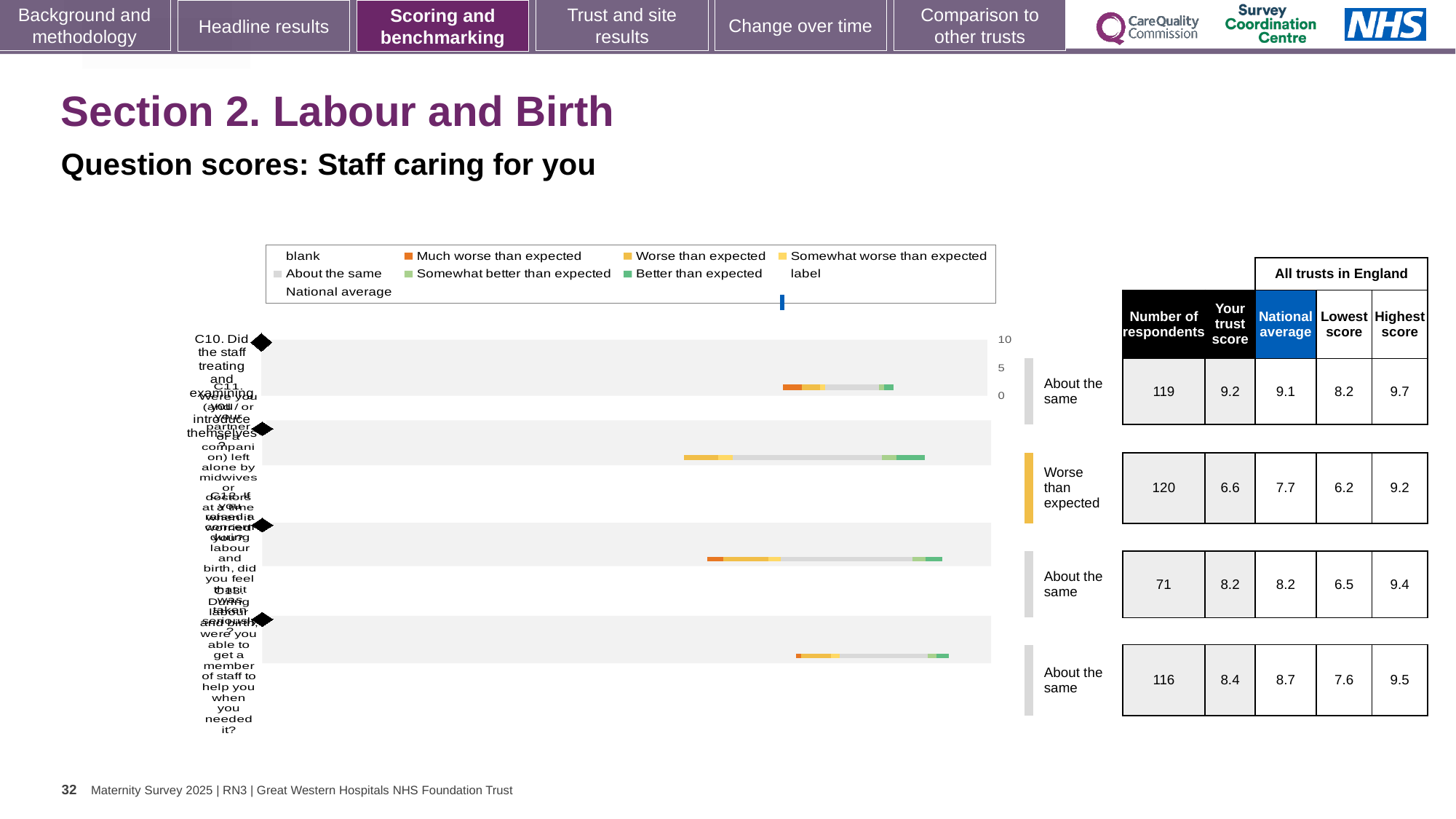
In the table, what is the number of respondents for the second row (the one rated 'Worse than expected')? 120 What is the lowest score among all trusts in England for the first row? 8.2 How many question rows are plotted in the chart? 4 How many of the four rows are rated 'About the same'? 3 What kind of chart is shown on the slide? bar chart For the first row, which is larger: the trust score or the national average? the trust score (9.2) For the row rated 'Worse than expected', what is the difference between the national average and the trust score? 1.1 Which row has the lowest number of respondents? the third row (71) Which row has the highest 'Your trust score' in the table? the first row (9.2) What is the 'Your trust score' for the row rated 'Worse than expected'? 6.6 What is the highest score among all trusts in England for the fourth row? 9.5 For the third row, what is the difference between the highest score and the lowest score? 2.9